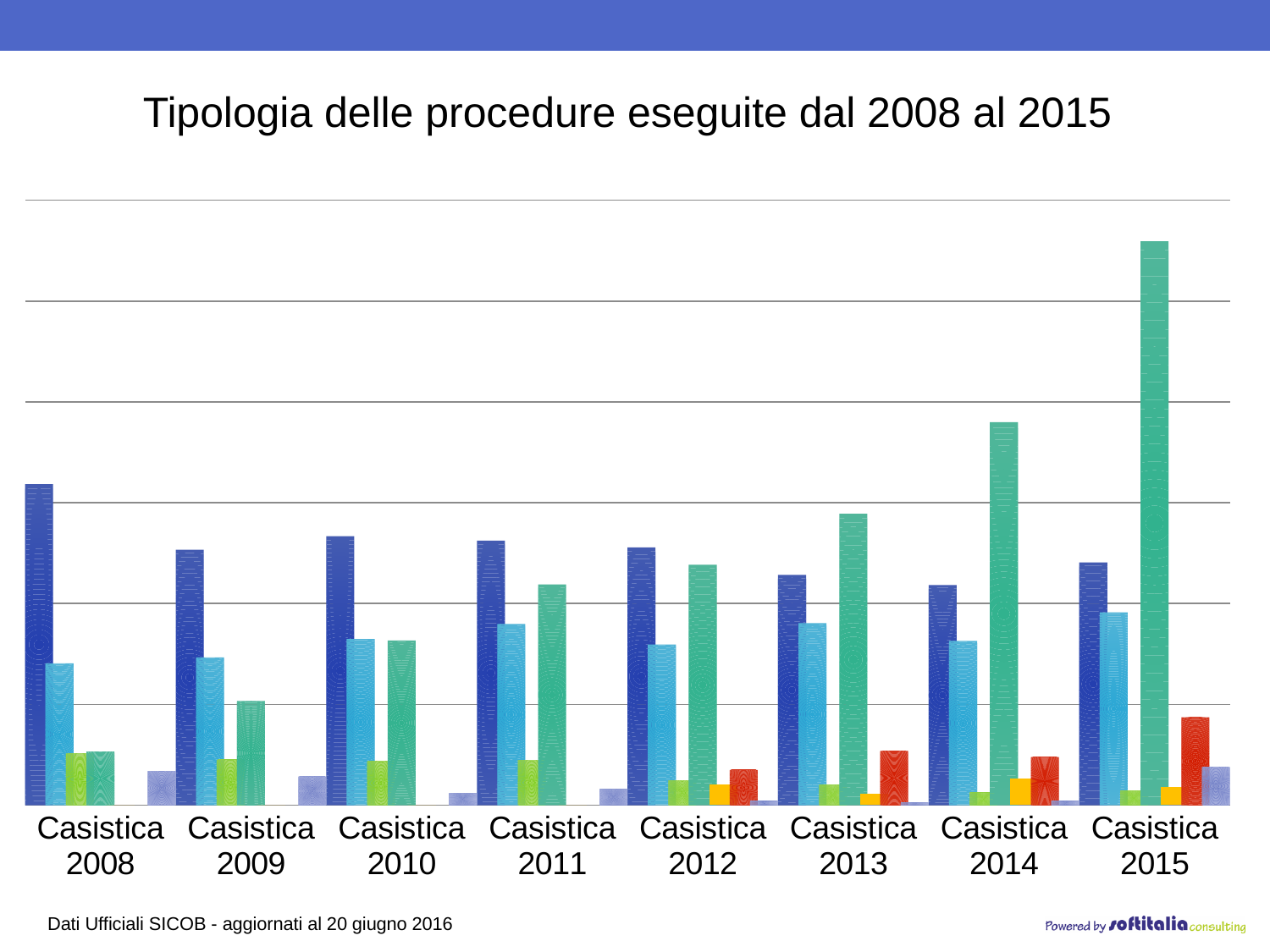
How many categories (years) are shown along the x axis of the chart? 8 Which category contains the tallest bar in the whole chart? Casistica 2015 Which category is the first one shown on the x axis? Casistica 2008 What is the title of the chart on the slide? Tipologia delle procedure eseguite dal 2008 al 2015 In which category is the dark blue bar the tallest? Casistica 2008 What kind of chart is shown on the slide? bar chart Does the green series rise or fall from Casistica 2012 to Casistica 2015? rise In which category is the green bar the shortest? Casistica 2008 In Casistica 2008, is the dark blue bar taller or shorter than the light blue bar? taller In Casistica 2015, is the green bar taller or shorter than the dark blue bar? taller